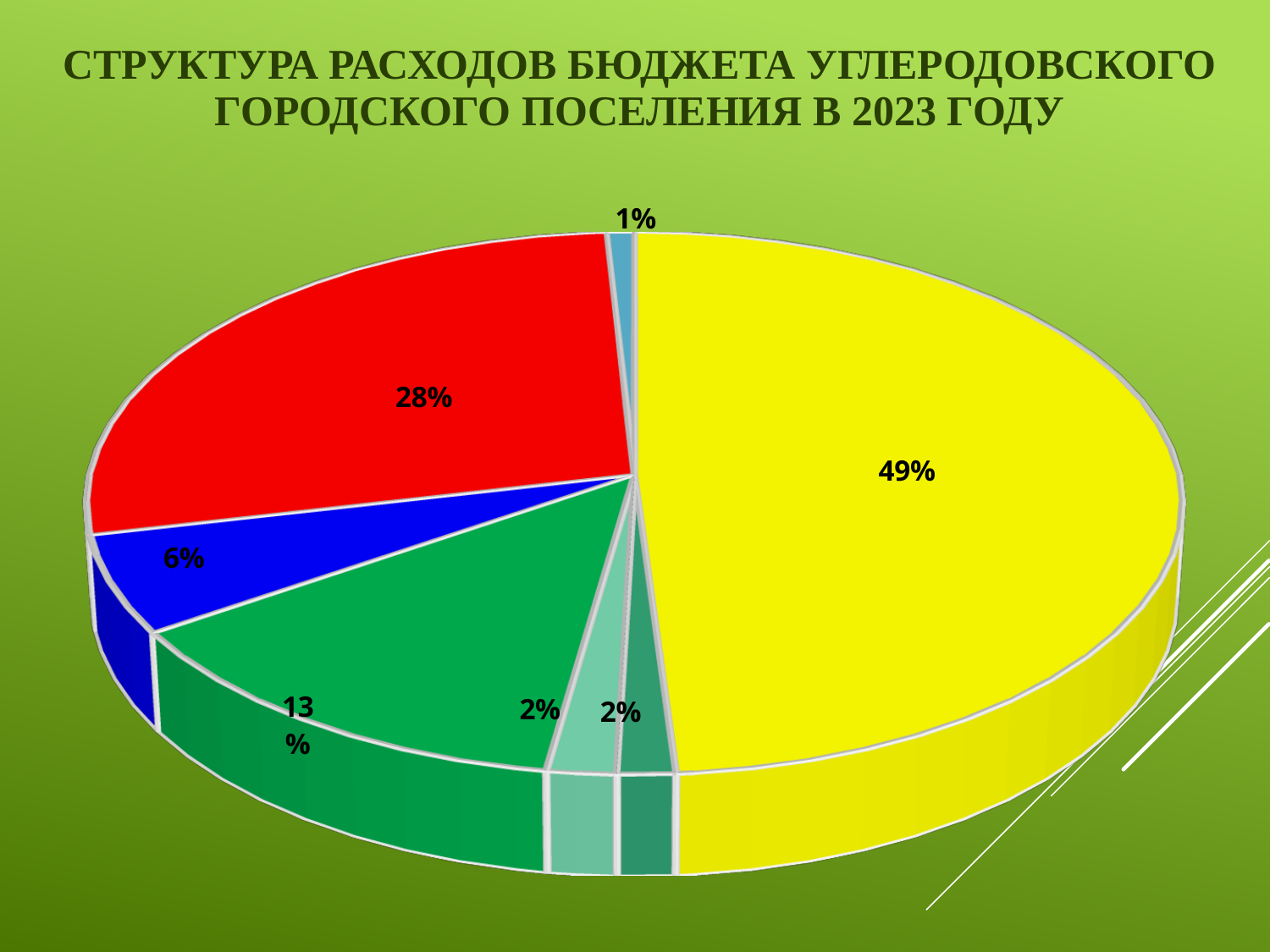
What kind of chart is shown on the slide? Pie chart What is the difference in percentage points between the yellow slice and the red slice? 21 Which colour slice is the largest in the pie chart? Yellow Which slice is larger, the blue slice or the dark green slice? Dark green What percentage is shown on the red slice of the pie chart? 28% What percentage is shown on the blue slice of the pie chart? 6% How many slices does the pie chart have? 7 What percentage is shown on the dark green slice of the pie chart? 13% What is the difference in percentage points between the dark green slice and the blue slice? 7 Which colour slice is the smallest in the pie chart? Light blue (1%) What year does the chart title say the budget expenditure structure refers to? 2023 What percentage is shown on the yellow slice of the pie chart? 49%